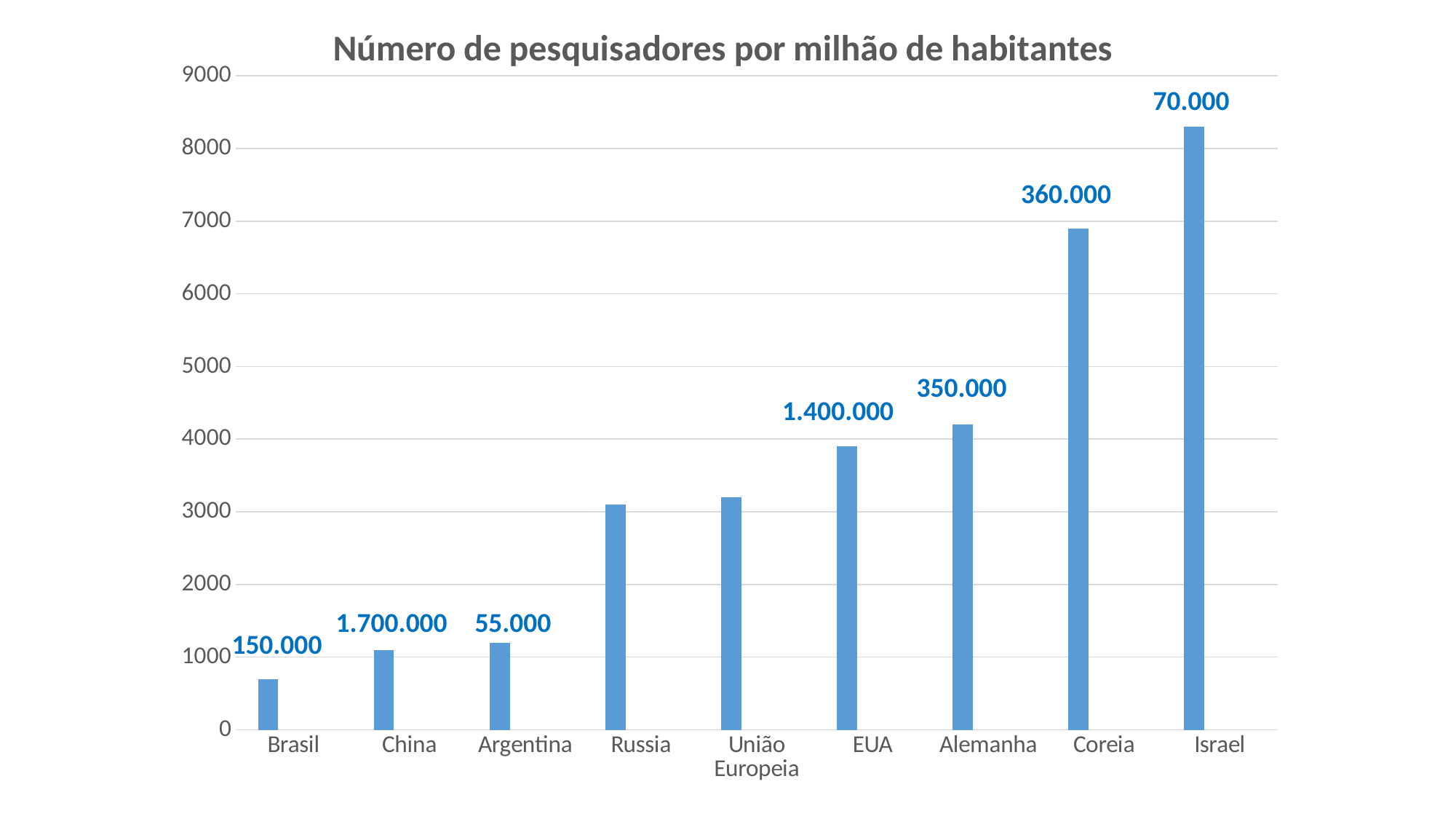
Is the value for Argentina greater or less than 2000? less Which has a larger value, Israel or Coreia? Israel Is the value for Israel greater or less than 8000? greater Is the value for Brasil greater or less than 1000? less How many countries or regions are shown on the x axis? 9 Which category has the lowest bar? Brasil Which has a larger value, Brasil or China? China Do the bar values generally rise or fall from left to right along the x axis? rise Which category has the highest bar? Israel What kind of chart is shown on the slide? bar chart What is the title of the chart? Número de pesquisadores por milhão de habitantes